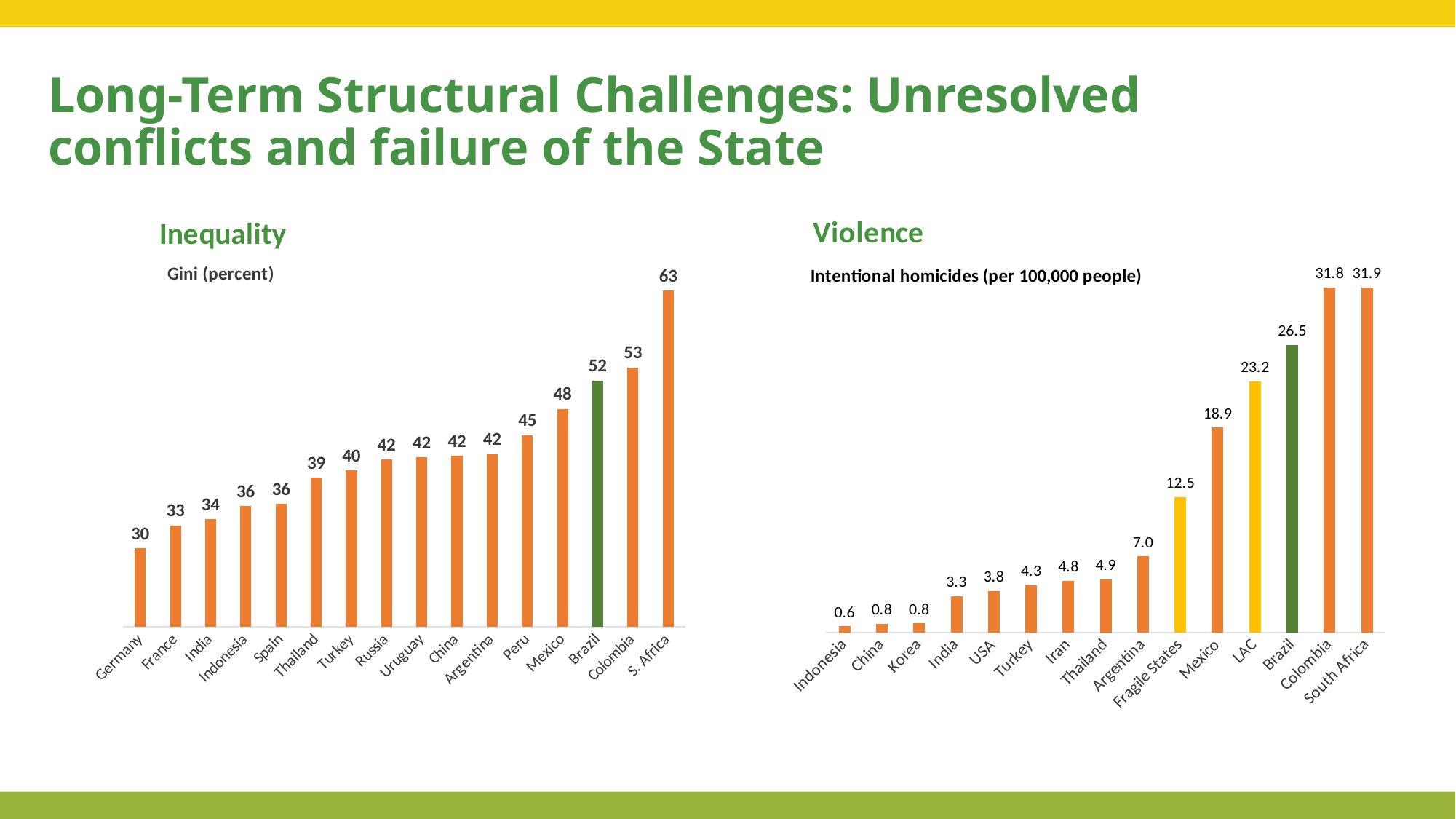
In the Inequality chart, how many countries are shown? 16 In the Violence chart, what is the intentional homicide rate for LAC? 23.2 In the Violence chart, what is the difference between the values for Brazil and LAC? 3.3 In the Inequality chart, which country has the lowest Gini value? Germany In the Violence chart, which category has the lowest intentional homicide rate? Indonesia In the Inequality chart, what is the Gini value for Brazil? 52 In the Inequality chart, what is the difference between the Gini values for S. Africa and Brazil? 11 In the Violence chart, how many categories are shown? 15 What type of chart is the Inequality chart? Bar chart In the Inequality chart, which country has the highest Gini value? S. Africa In the Violence chart, which is larger, the value for Mexico or the value for Fragile States? Mexico In the Violence chart, what is the intentional homicide rate for Brazil? 26.5